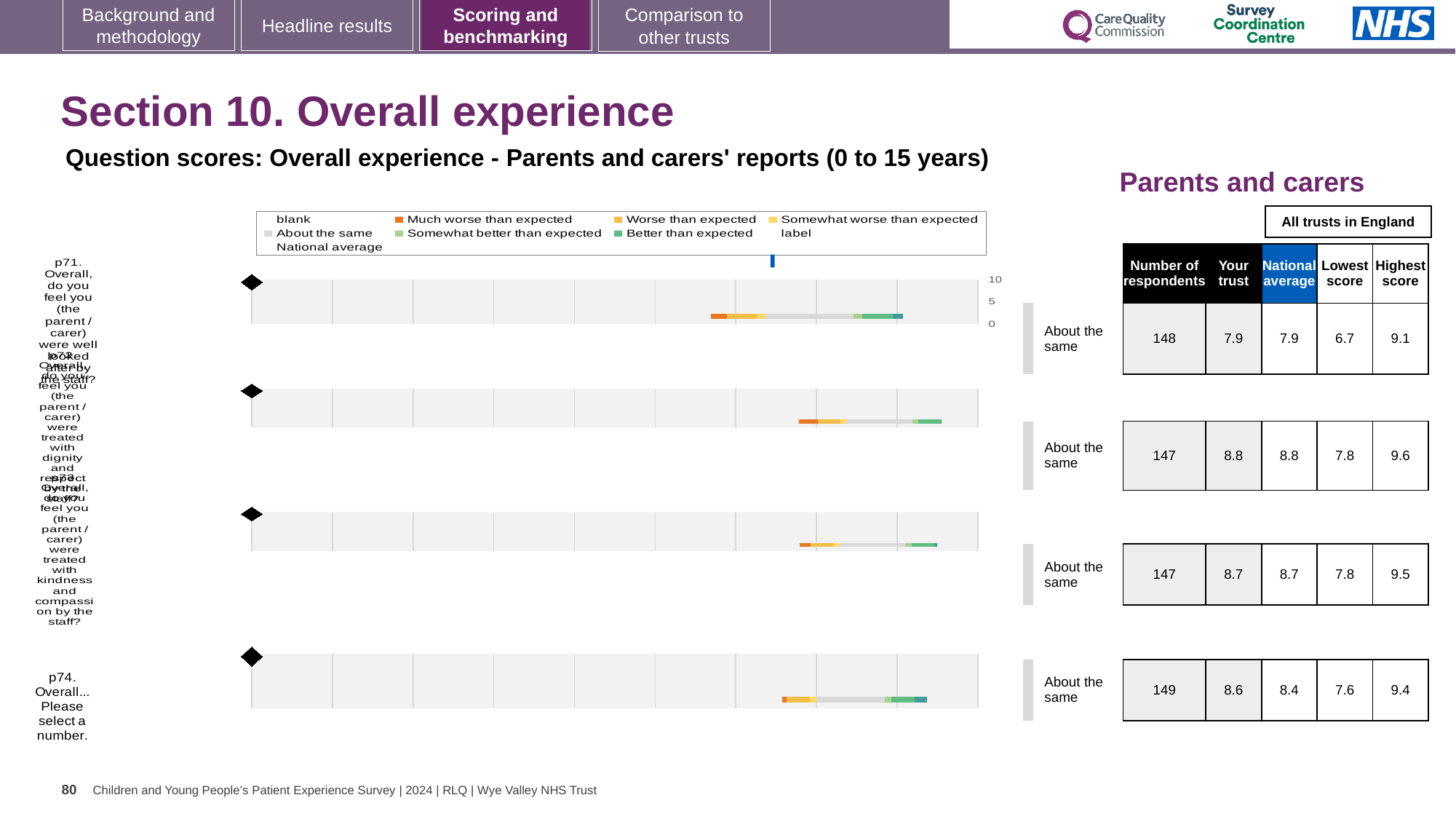
What is the highest score across all trusts in England for the second question row? 9.6 How many entries does the chart legend list? 9 What is the 'Your trust' score for p74 (Overall... Please select a number)? 8.6 What is the difference between the 'Your trust' score and the national average for p74? 0.2 Which has the larger 'Your trust' score, the second question row or the third question row? the second row What kind of chart is used to show the question scores on this slide? bar chart How many respondents are listed for p71 (were well looked after by the staff)? 148 Which question row has the highest 'Your trust' score? the second row (8.8) What benchmark category is shown for p71? About the same How many question rows are plotted in the chart? 4 Which question has the lowest 'Your trust' score? p71 (7.9) What is the national average score for p74? 8.4